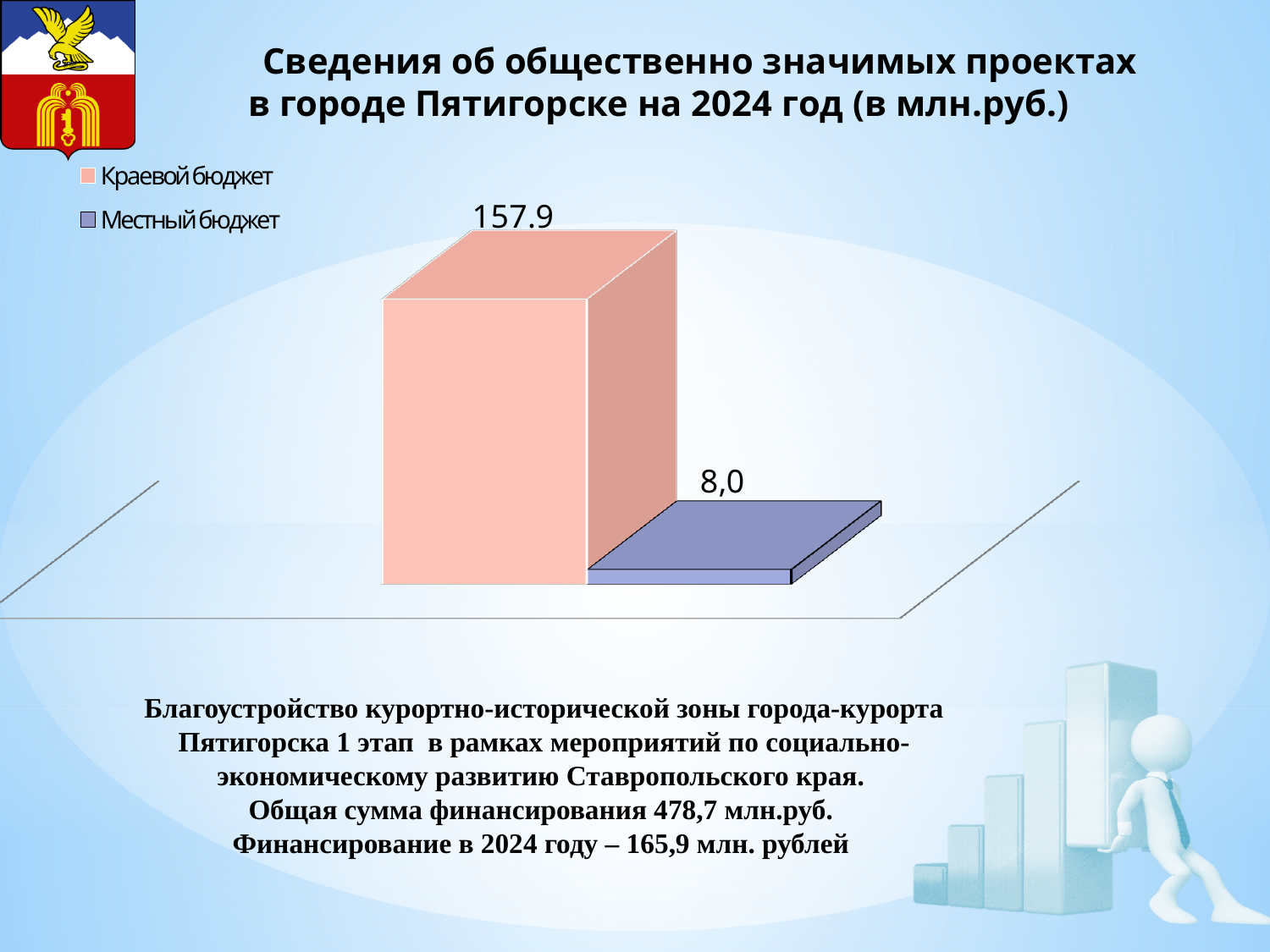
Is the value for Краевой бюджет greater or less than 100? greater How many bars are plotted on the chart? 2 What is the value for Местный бюджет? 8,0 Which series has the lowest value? Местный бюджет What kind of chart is shown on the slide? Bar chart Which series has the highest value? Краевой бюджет Which is larger, Краевой бюджет or Местный бюджет? Краевой бюджет What is the difference between the values for Краевой бюджет and Местный бюджет? 149.9 What is the value for Краевой бюджет? 157.9 Which legend entry is shown in pink? Краевой бюджет How many series does the legend list? 2 Which legend entry is shown in blue-purple? Местный бюджет